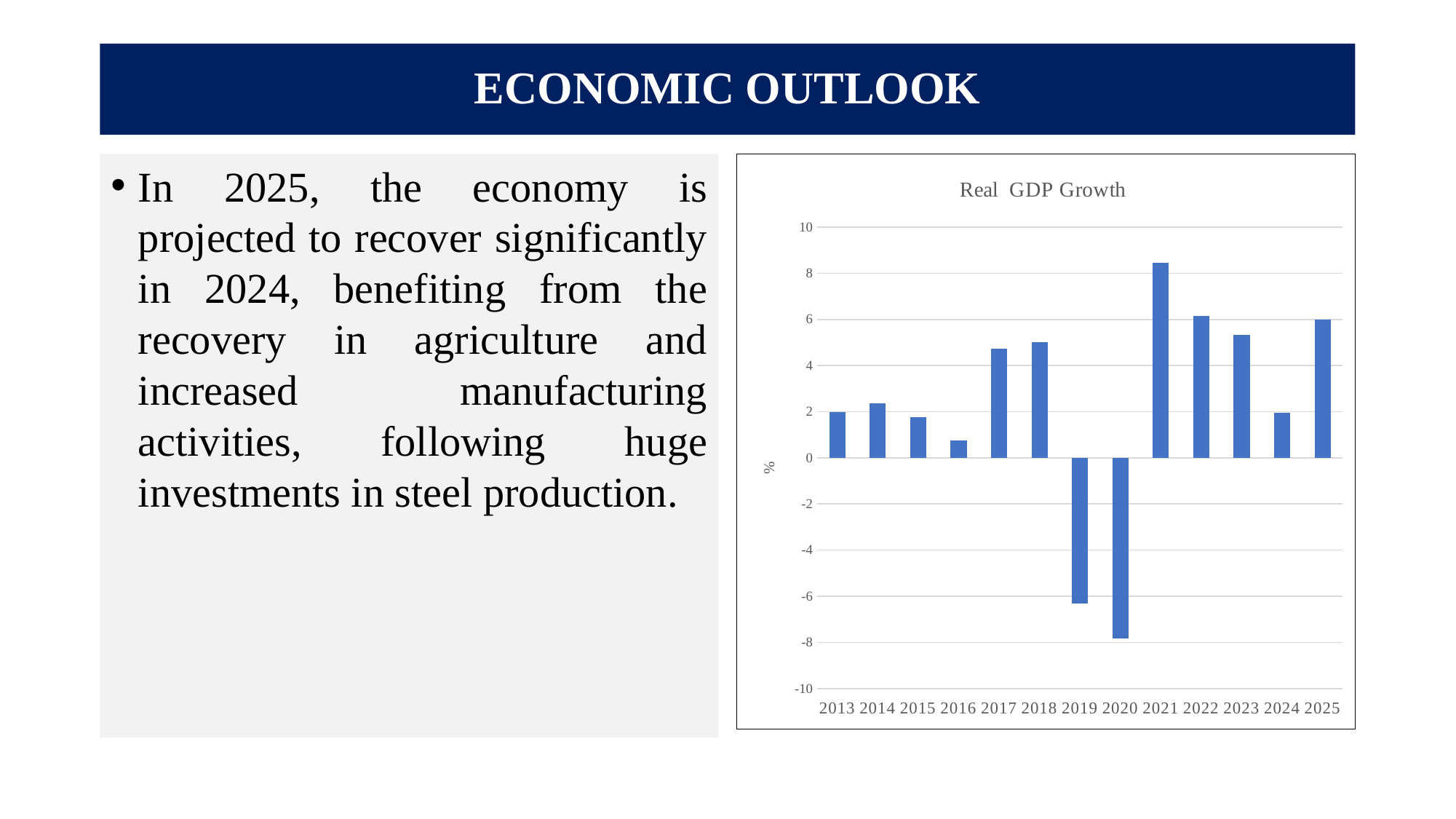
Is the value for 2020 less or greater than -6? less Is the value for 2016 greater or less than 2? less Is the value for 2021 greater or less than 8? greater What type of chart is shown on the slide? bar chart What is the title of the chart? Real GDP Growth Which year has the larger Real GDP Growth, 2021 or 2022? 2021 Which year has the highest Real GDP Growth? 2021 Which year has the lowest Real GDP Growth? 2020 How many years are shown on the x axis of the chart? 13 Do the values rise or fall from 2021 to 2024? fall Which year has the larger Real GDP Growth, 2014 or 2016? 2014